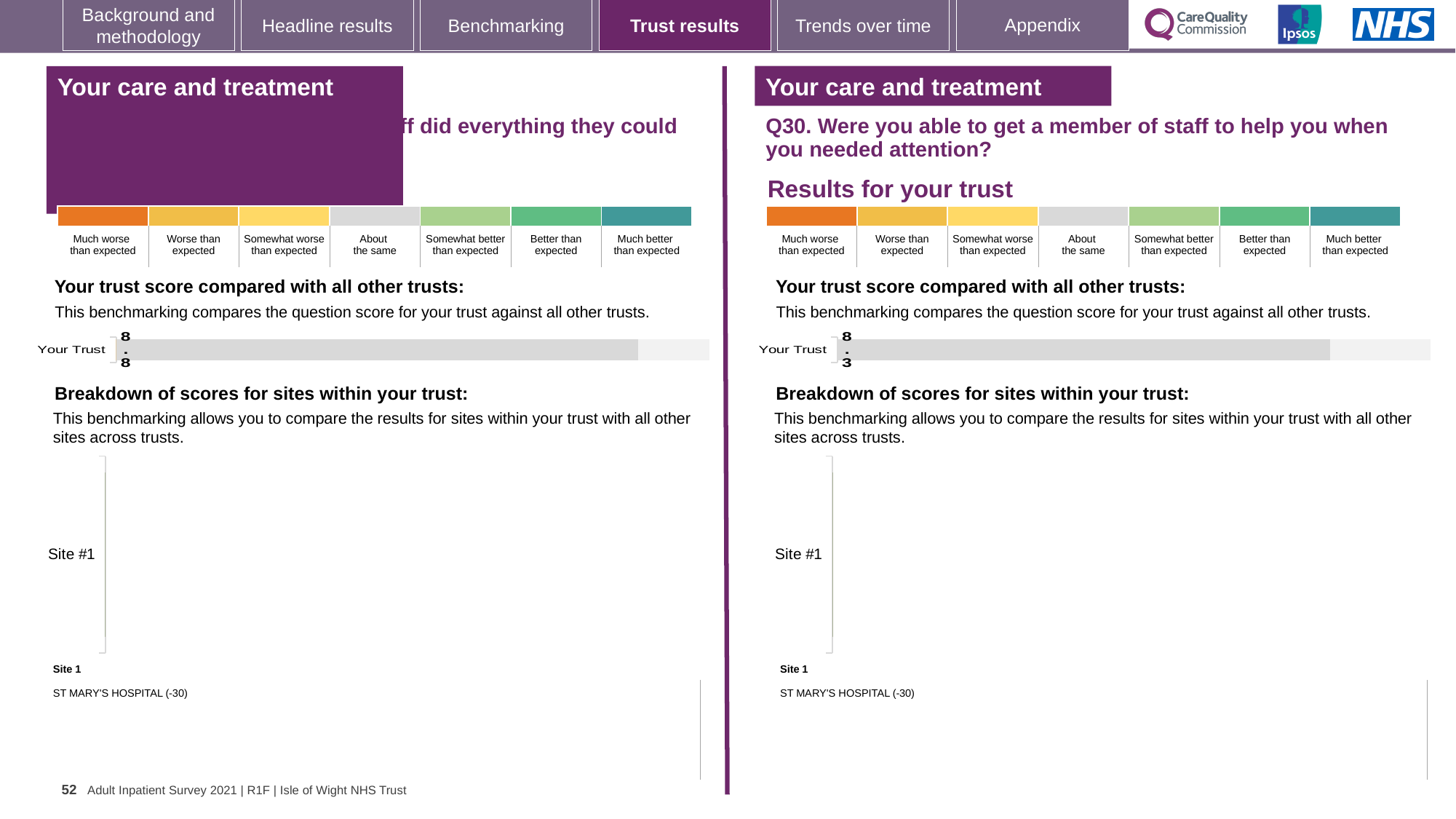
On the left-hand 'Your trust score compared with all other trusts' chart, what is the score shown for Your Trust? 8.8 On the right-hand Q30 panel, what is the name of the site listed under 'Site 1' in the breakdown of scores for sites? ST MARY'S HOSPITAL (-30) On the right-hand chart for Q30, what is the score shown for Your Trust? 8.3 How many rating categories does the colour scale above the right-hand Q30 chart show, from 'Much worse than expected' to 'Much better than expected'? 7 Is the Your Trust score on the right-hand Q30 chart greater or less than the Your Trust score on the left-hand chart? less What kind of chart is used to show the Your Trust score on the right-hand Q30 panel? Bar chart Which Your Trust score is larger: the one on the left-hand chart or the one on the right-hand Q30 chart? The left-hand chart How many categories are plotted in the 'Your trust score compared with all other trusts' chart on the right-hand Q30 panel? 1 What is the difference between the Your Trust score on the left-hand chart (8.8) and the Your Trust score on the right-hand Q30 chart (8.3)? 0.5 What is the label of the single bar in the left-hand 'Your trust score compared with all other trusts' chart? Your Trust